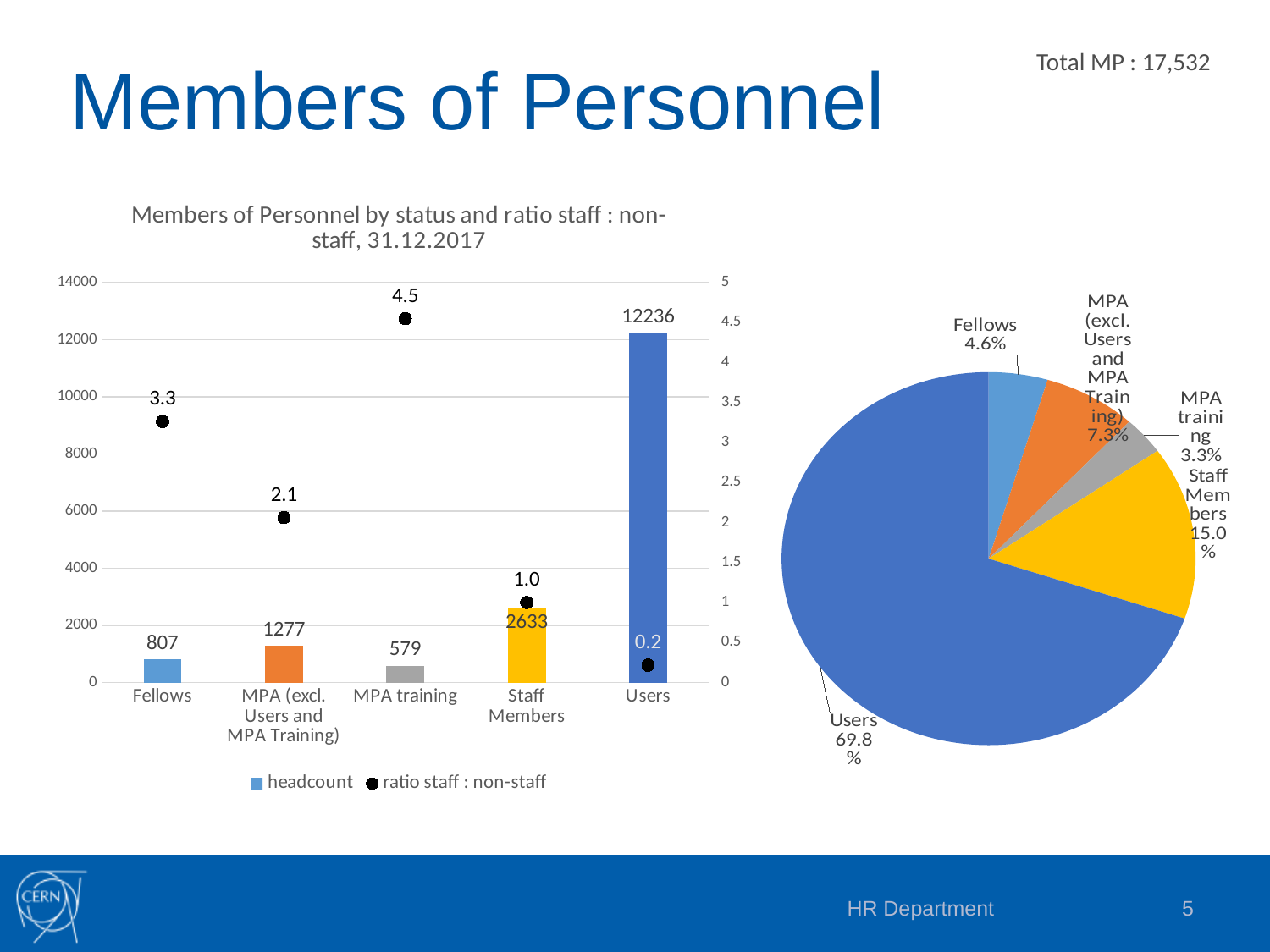
In the left chart, what is the ratio staff : non-staff for MPA training? 4.5 How many categories are shown on the x axis of the left chart? 5 In the left chart, what is the difference in headcount between Staff Members and Fellows? 1826 What kind of chart is shown on the right of the slide? Pie chart In the left chart, which category has the highest headcount? Users In the pie chart on the right, what share do Staff Members have? 15.0% In the left chart titled 'Members of Personnel by status and ratio staff : non-staff, 31.12.2017', what is the headcount for Staff Members? 2633 In the left chart, which has the larger headcount, Fellows or MPA (excl. Users and MPA Training)? MPA (excl. Users and MPA Training) In the left chart, which category has the lowest headcount? MPA training In the pie chart on the right, what share do Users have? 69.8% How many series does the legend of the left chart list? 2 In the left chart, which category has the lowest ratio staff : non-staff? Users